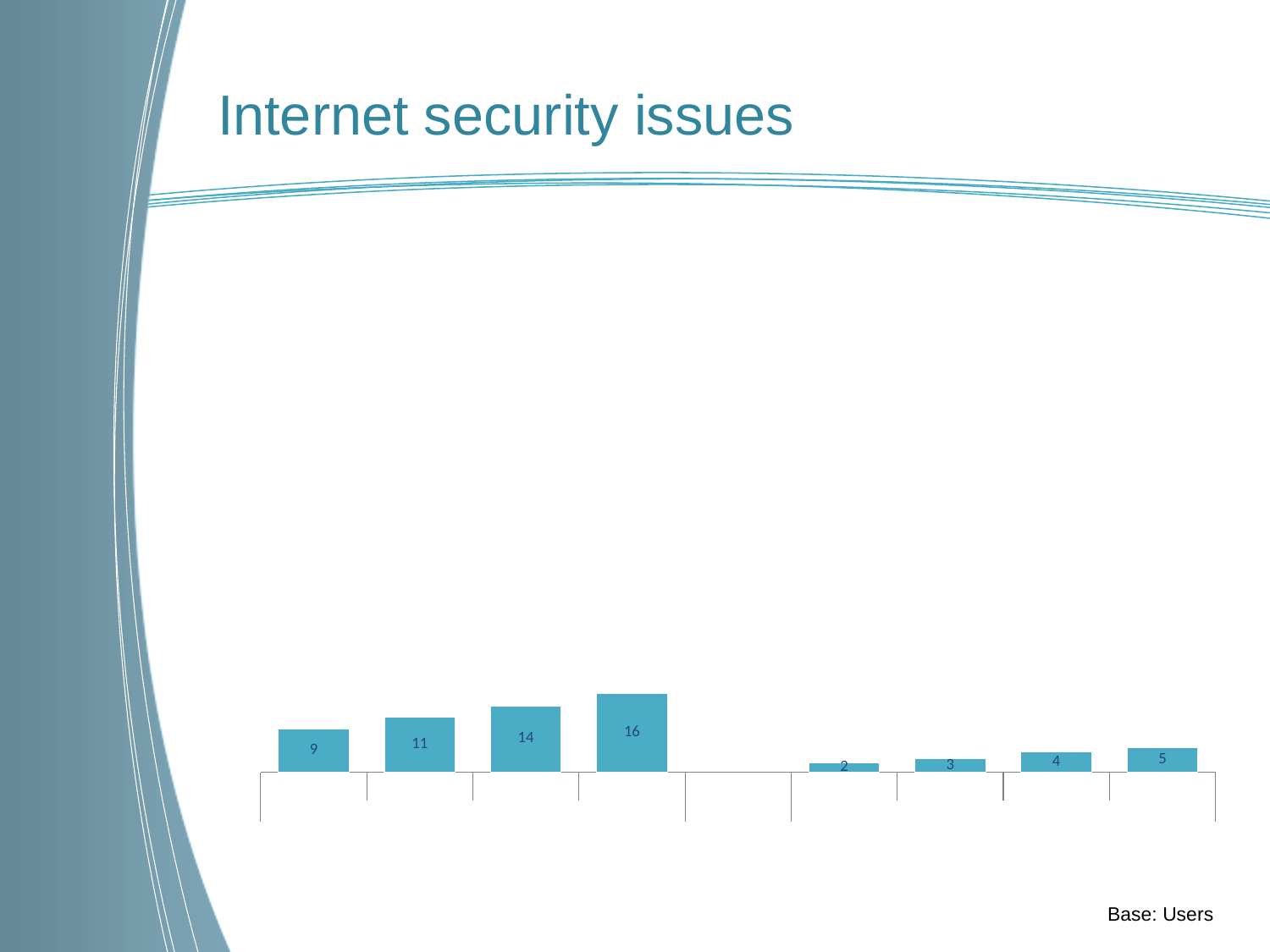
What is the value shown on the shortest bar in the chart? 2 What is the difference between the tallest bar (16) and the shortest bar (2)? 14 What is the difference between the first bar (9) and the last bar (5)? 4 What is the value of the fourth bar from the left in the chart? 16 How many bars with data labels are shown in the chart? 8 What is the value of the last bar on the right of the chart? 5 What is the value of the first bar from the left in the chart? 9 Do the values of the first four bars rise or fall from left to right? rise What is the title of the slide containing the chart? Internet security issues What kind of chart is shown on the slide? bar chart What is the value shown on the tallest bar in the chart? 16 Which is larger, the first bar from the left or the last bar on the right? the first bar from the left